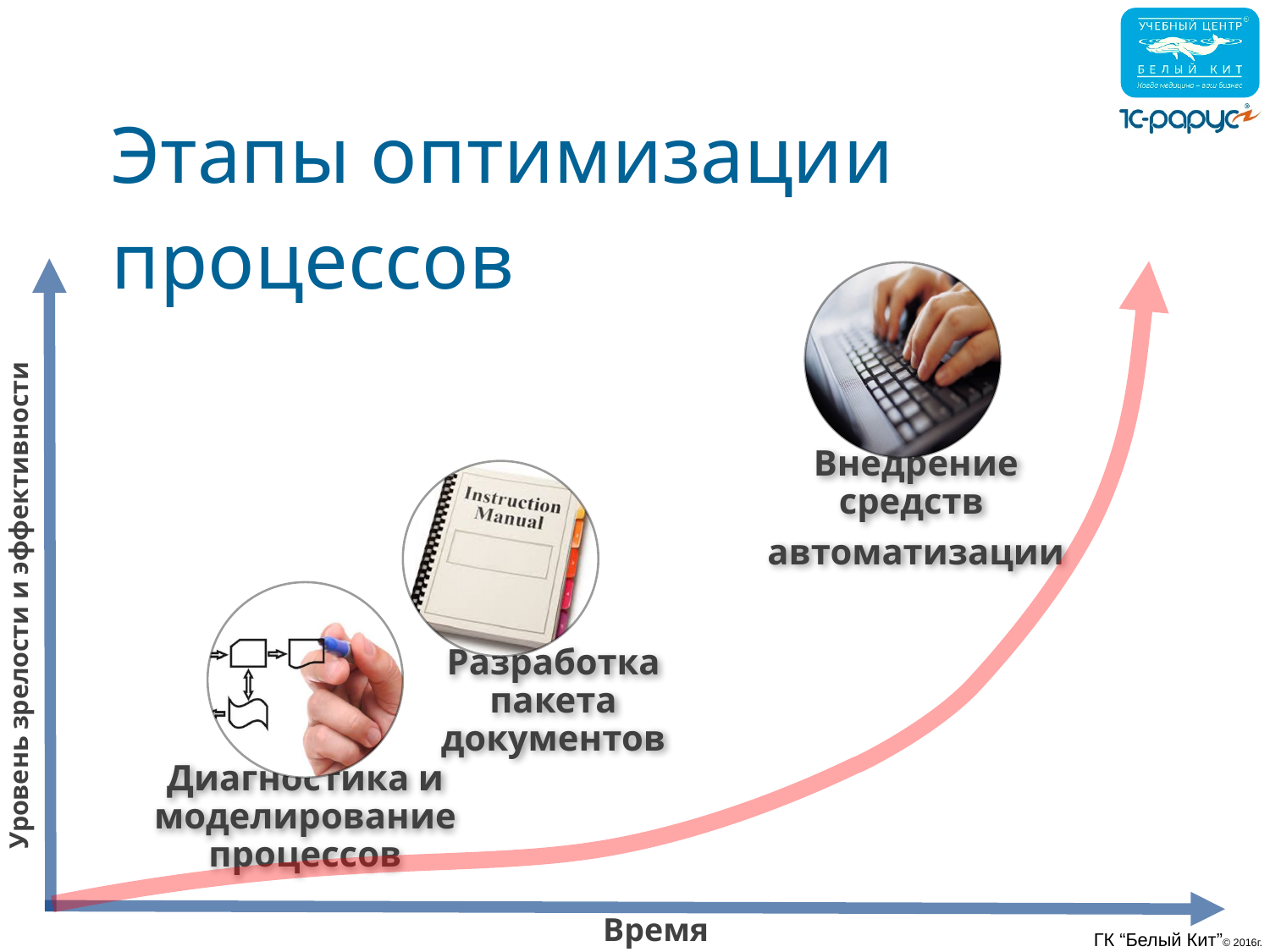
Which stage is placed higher on the curve: Разработка пакета документов or Диагностика и моделирование процессов? Разработка пакета документов Which stage is placed lowest on the curve? Диагностика и моделирование процессов How many stages are marked along the curve on the chart? 3 Which stage is placed highest on the curve? Внедрение средств автоматизации What is the label of the vertical axis of the chart? Уровень зрелости и эффективности What is the label of the horizontal axis of the chart? Время Does the curve on the chart rise or fall along the x axis (Время)? rise